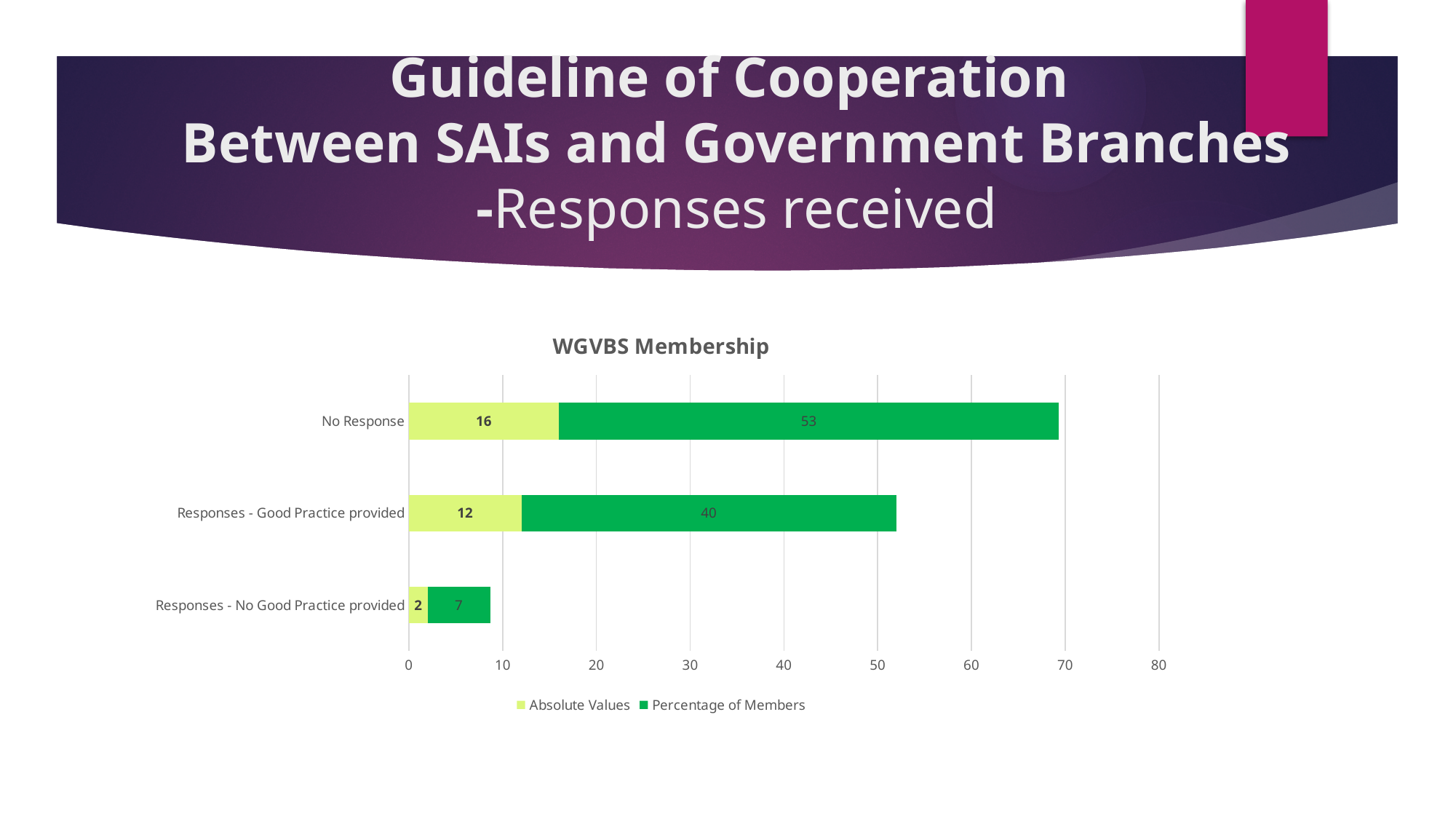
What type of chart is shown on the slide? Stacked bar chart What is the total of the stacked bar for No Response? 69 Which is larger: the Percentage of Members for Responses - Good Practice provided or for Responses - No Good Practice provided? Responses - Good Practice provided What is the difference between the Absolute Values for No Response and Responses - Good Practice provided? 4 Which category has the highest Percentage of Members value? No Response What is the Absolute Values figure for Responses - No Good Practice provided? 2 How many categories are shown on the chart? 3 What is the Absolute Values figure for No Response? 16 Which category has the lowest Absolute Values figure? Responses - No Good Practice provided What is the Percentage of Members value for Responses - Good Practice provided? 40 How many series does the legend list? 2 What is the title of the chart? WGVBS Membership